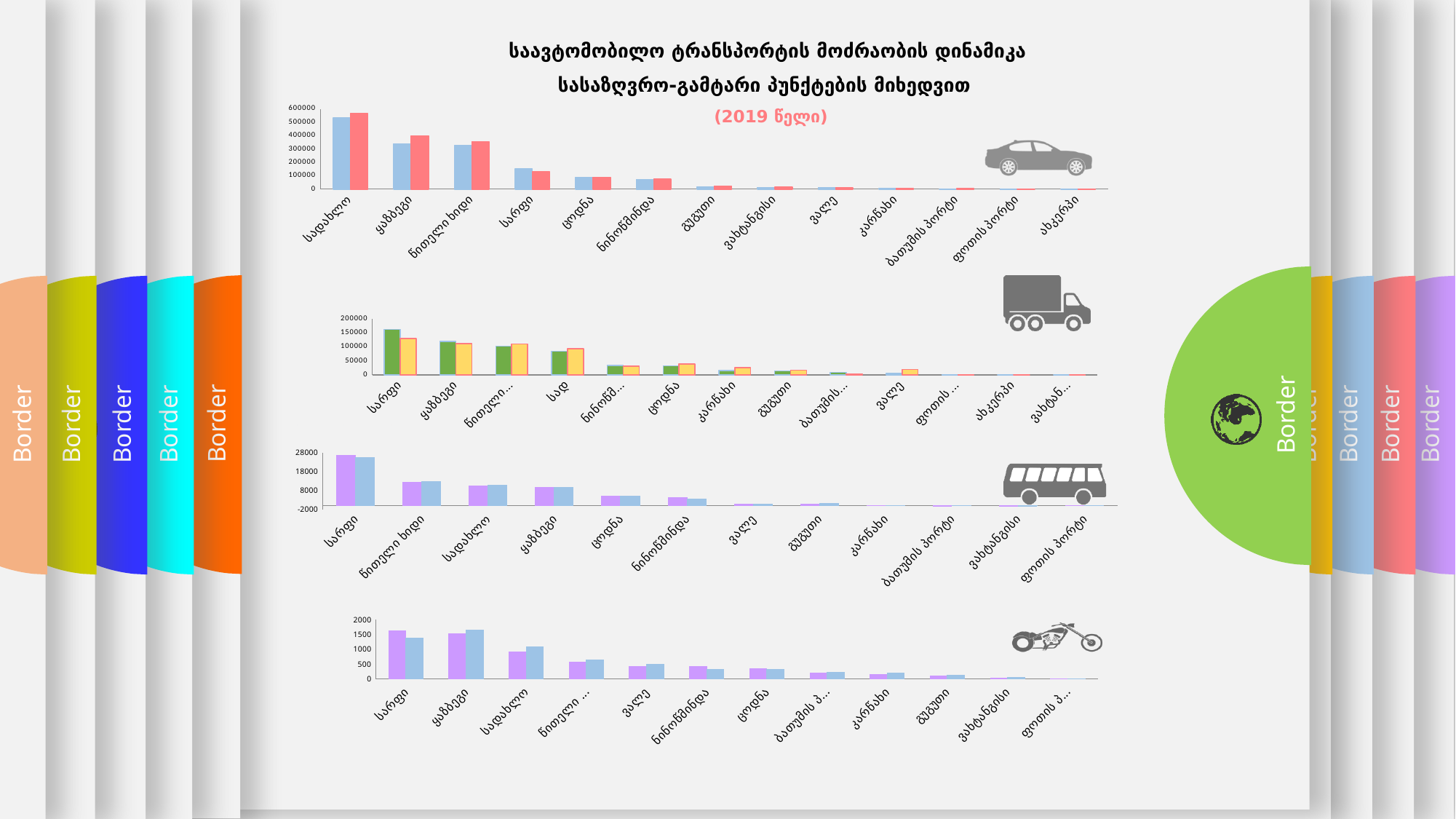
In the second chart (truck icon), which category has the highest values? სარფი How many categories are shown on the x axis of the bottom chart (motorcycle icon)? 12 In the top chart (car icon), is the value of the blue bar for სარფი greater or less than 200000? less Which year is shown in the slide title? 2019 In the third chart (bus icon), is the value of the purple bar for სარფი greater or less than 18000? greater How many categories are shown on the x axis of the top chart (car icon)? 13 In the top chart (car icon), is the value of the blue bar for სადახლო greater or less than 500000? greater In the top chart (car icon), which category has the highest values? სადახლო In the third chart (bus icon), which is larger: the purple bar for სარფი or the purple bar for ყაზბეგი? სარფი What kind of chart is the top chart (with the car icon)? bar chart In the bottom chart (motorcycle icon), do the values generally rise or fall from left to right along the x axis? fall